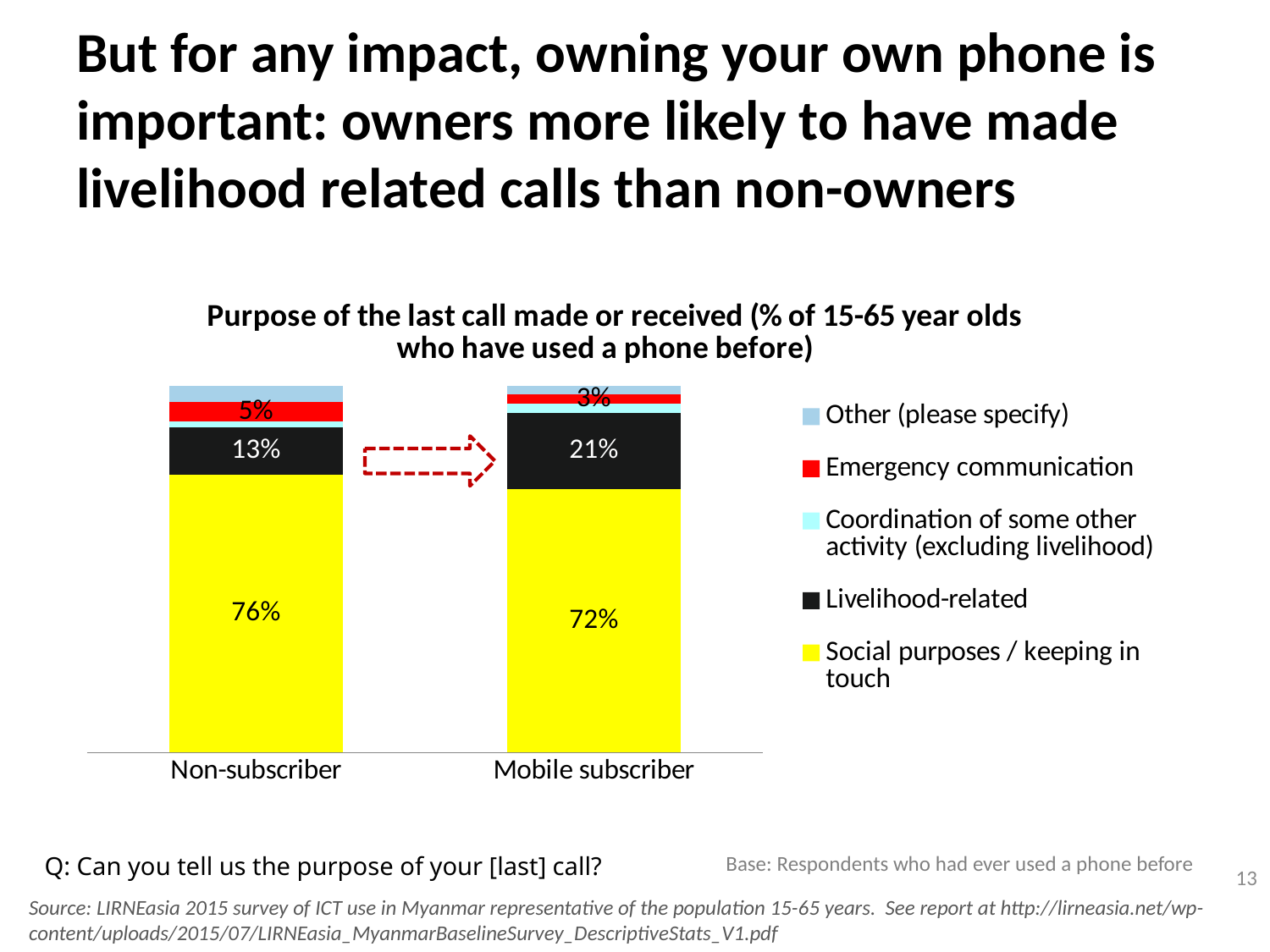
What is the value for Livelihood-related for Mobile subscriber? 21% What is the value for Social purposes / keeping in touch for Non-subscriber? 76% How many categories are shown on the x axis of the chart? 2 What kind of chart is shown on the slide? stacked bar chart How many series does the legend list? 5 Which category has the larger Livelihood-related value, Non-subscriber or Mobile subscriber? Mobile subscriber Which category has the larger Social purposes / keeping in touch value, Non-subscriber or Mobile subscriber? Non-subscriber What is the difference between the Livelihood-related values for Mobile subscriber and Non-subscriber? 8% What is the value for Livelihood-related for Non-subscriber? 13% What is the value for Social purposes / keeping in touch for Mobile subscriber? 72% What is the value for Emergency communication for Non-subscriber? 5% What is the value for Emergency communication for Mobile subscriber? 3%